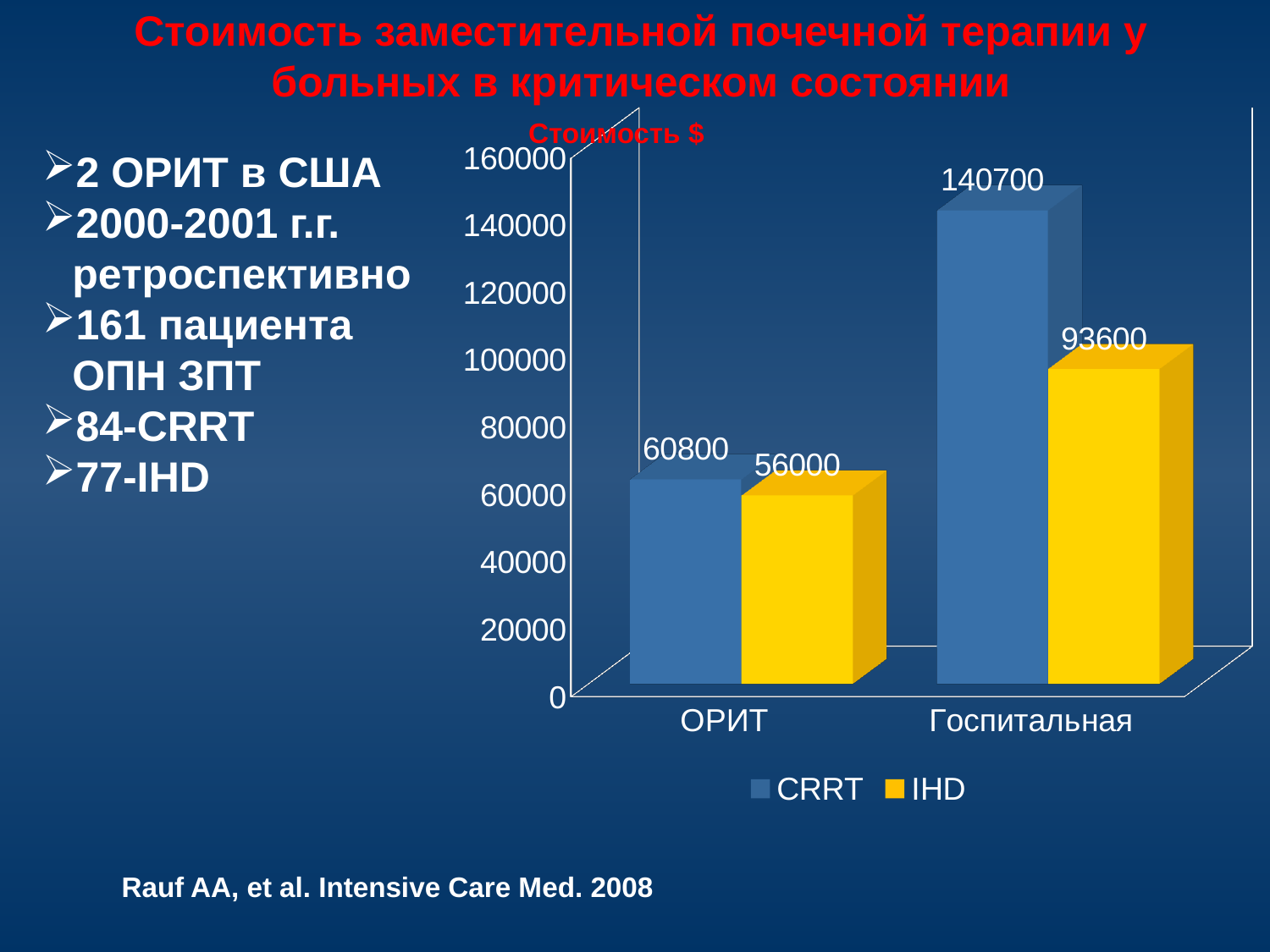
What is the CRRT value for Госпитальная? 140700 Which bar has the highest value on the chart? CRRT, Госпитальная How many series does the legend list? 2 What is the difference between the CRRT and IHD values for Госпитальная? 47100 What kind of chart is shown on the slide? Bar chart What is the CRRT value for ОРИТ? 60800 What is the IHD value for Госпитальная? 93600 Which is larger for Госпитальная, CRRT or IHD? CRRT What is the difference between the CRRT and IHD values for ОРИТ? 4800 Which bar has the lowest value on the chart? IHD, ОРИТ How many categories are shown on the x axis? 2 What is the IHD value for ОРИТ? 56000